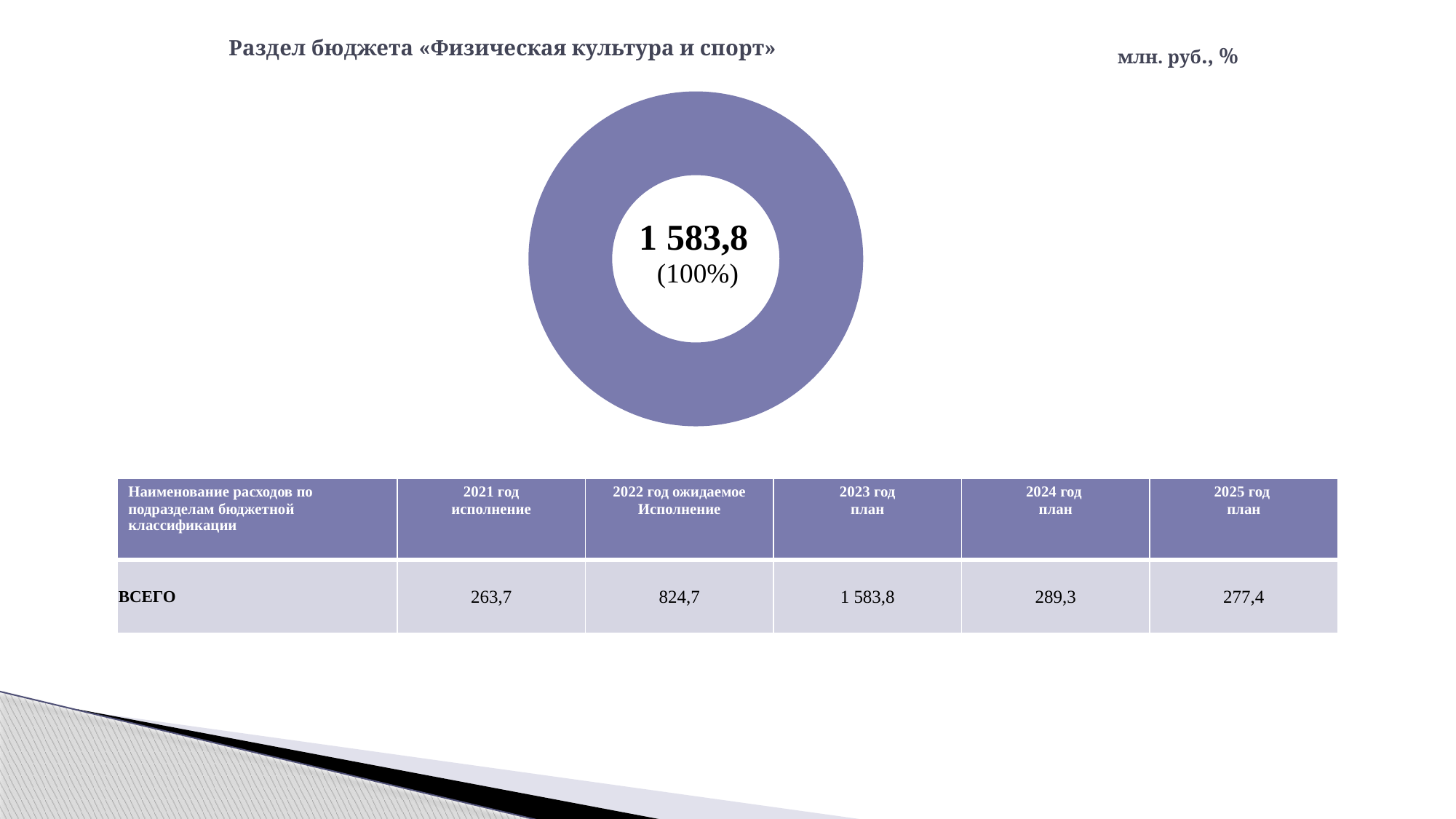
Is the value shown in the doughnut chart greater or less than 1 000? greater What share of the whole does the single slice of the doughnut chart represent? 100% What kind of chart is shown on the slide? Doughnut (pie) chart What units are indicated for the chart values in the top right of the slide? млн. руб., % What value is printed in the centre of the doughnut chart? 1 583,8 What is the title of the slide above the doughnut chart? Раздел бюджета «Физическая культура и спорт» How many slices does the doughnut chart contain? 1